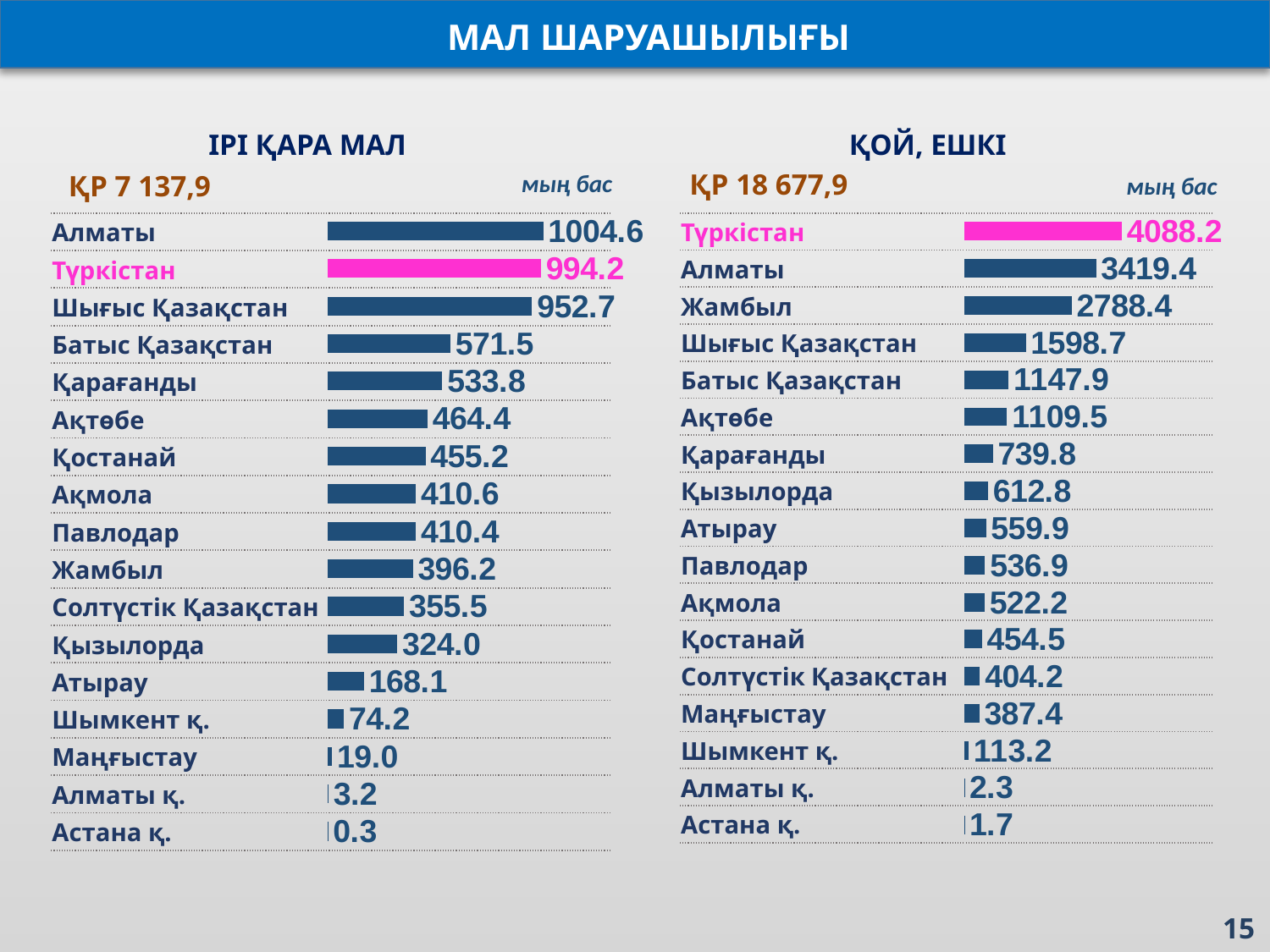
What type of chart is the ҚОЙ, ЕШКІ chart? Bar chart In the ІРІ ҚАРА МАЛ chart, what is the value for Алматы? 1004.6 In the ҚОЙ, ЕШКІ chart, which region has the highest value? Түркістан In the ҚОЙ, ЕШКІ chart, what is the value for Түркістан? 4088.2 In the ІРІ ҚАРА МАЛ chart, which region's bar is highlighted in pink? Түркістан In the ІРІ ҚАРА МАЛ chart, which region has the lowest value? Астана қ. In the ІРІ ҚАРА МАЛ chart, which is larger: Батыс Қазақстан or Қарағанды? Батыс Қазақстан In the ІРІ ҚАРА МАЛ chart, what is the difference between Алматы and Түркістан? 10.4 In the ҚОЙ, ЕШКІ chart, which is larger: Жамбыл or Шығыс Қазақстан? Жамбыл How many regions are listed in the ІРІ ҚАРА МАЛ chart? 17 In the ҚОЙ, ЕШКІ chart, what is the value for Маңғыстау? 387.4 In the ҚОЙ, ЕШКІ chart, what is the difference between Түркістан and Алматы? 668.8